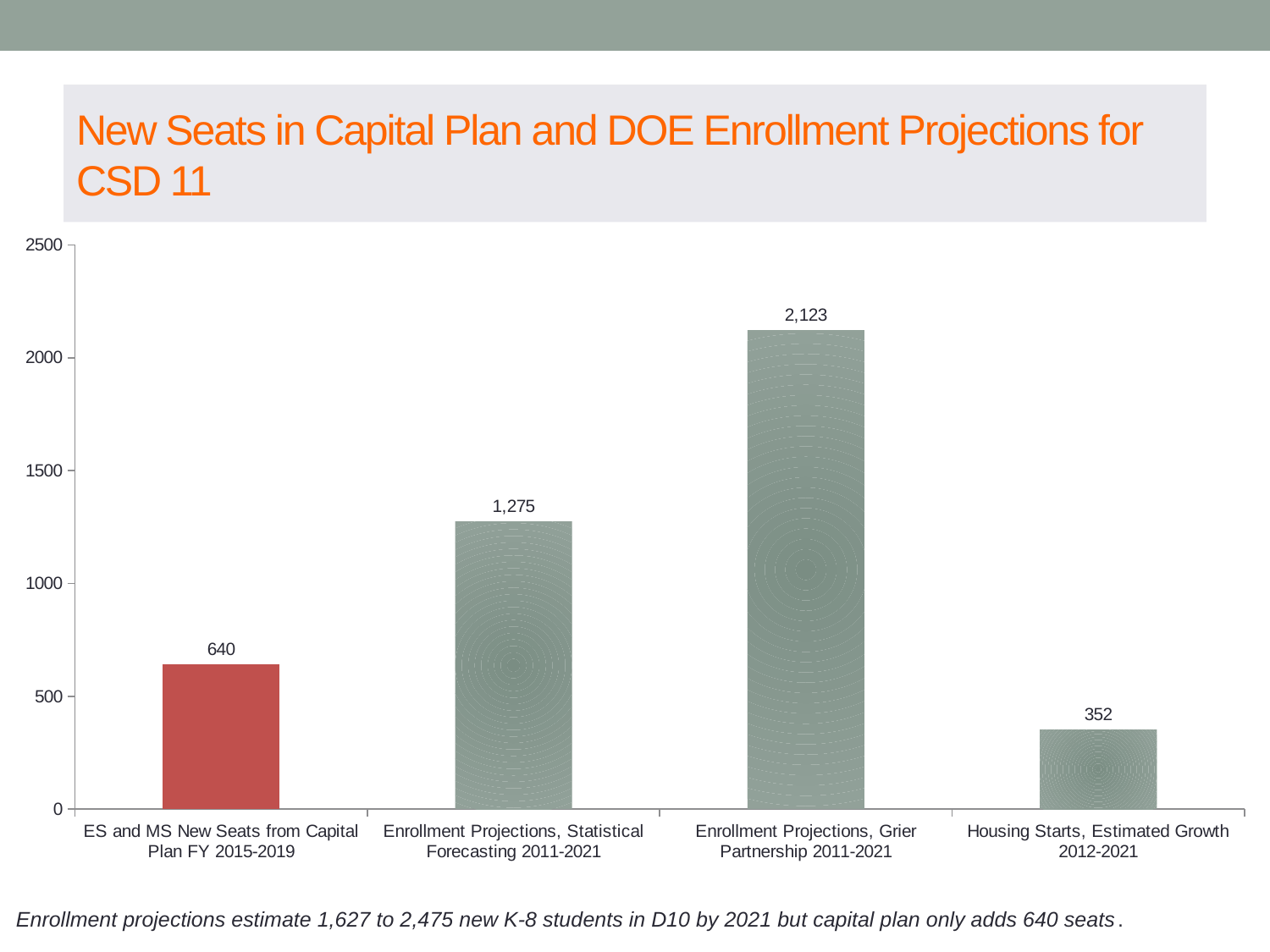
Which category has the highest value? Enrollment Projections, Grier Partnership 2011-2021 What is the difference between the Grier Partnership projection and the Statistical Forecasting projection? 848 What is the value for Enrollment Projections, Statistical Forecasting 2011-2021? 1,275 Is the value for Enrollment Projections, Grier Partnership 2011-2021 greater or less than 2000? greater Which is larger: ES and MS New Seats from Capital Plan FY 2015-2019 or Housing Starts, Estimated Growth 2012-2021? ES and MS New Seats from Capital Plan FY 2015-2019 What kind of chart is shown on the slide? Bar chart What is the difference between the Statistical Forecasting projection and the ES and MS New Seats from Capital Plan? 635 What is the value for ES and MS New Seats from Capital Plan FY 2015-2019? 640 How many categories are shown in the chart? 4 What is the value for Enrollment Projections, Grier Partnership 2011-2021? 2,123 What is the value for Housing Starts, Estimated Growth 2012-2021? 352 Which category has the lowest value? Housing Starts, Estimated Growth 2012-2021